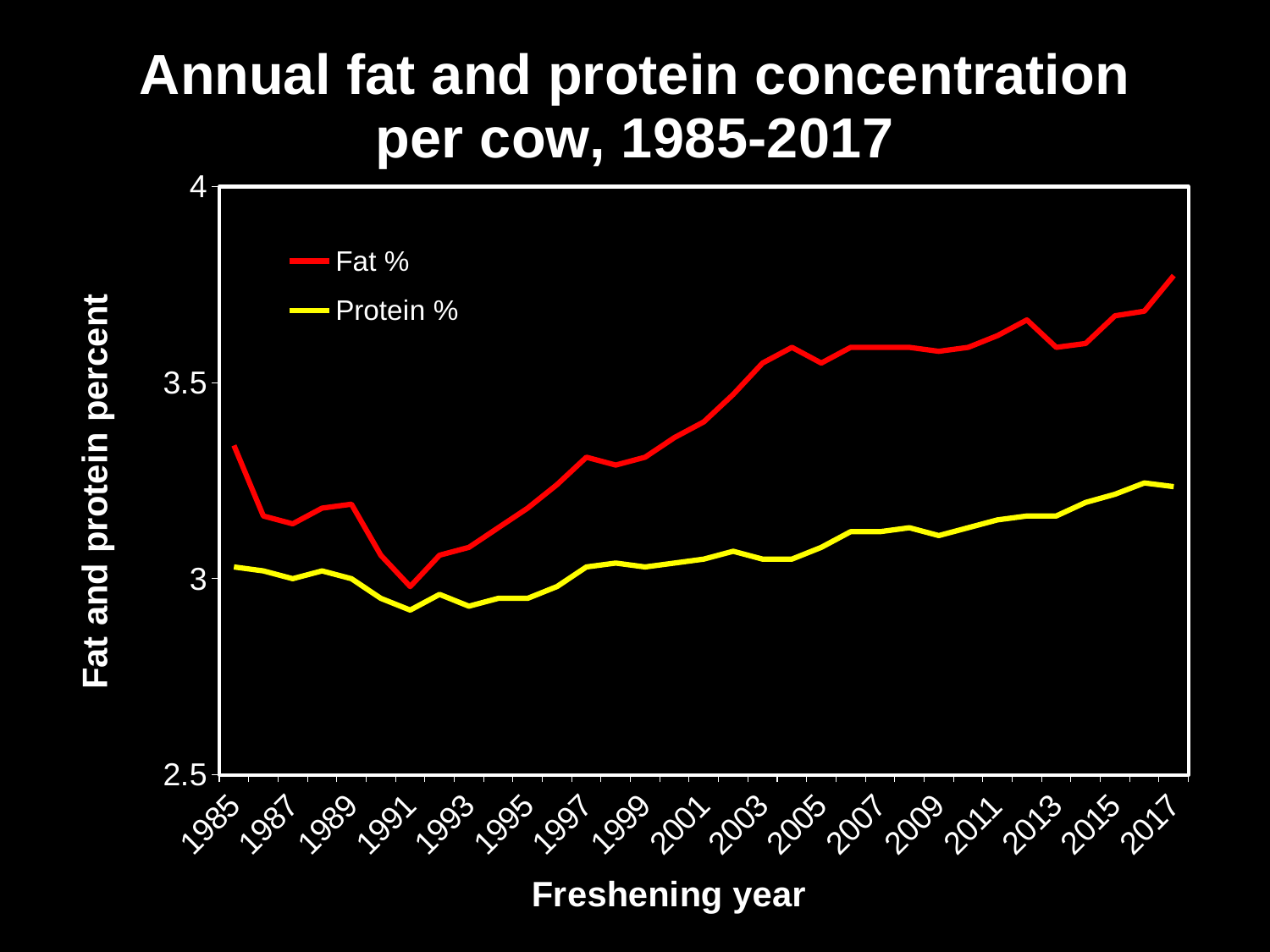
In which year is the Fat % line at its highest? 2017 Does the Protein % line rise or fall overall from 1991 to 2017? rise What kind of chart is shown on the slide? line chart Is the Protein % value for 2017 greater or less than 3.5? less What is the title of the chart? Annual fat and protein concentration per cow, 1985-2017 What colour is the Protein % line? yellow Is the Fat % value for 2017 greater or less than 3.5? greater Is the Protein % value for 1991 greater or less than 3? less In which year is the Fat % line at its lowest? 1991 How many series does the legend list? 2 In 2017, which is larger, Fat % or Protein %? Fat %